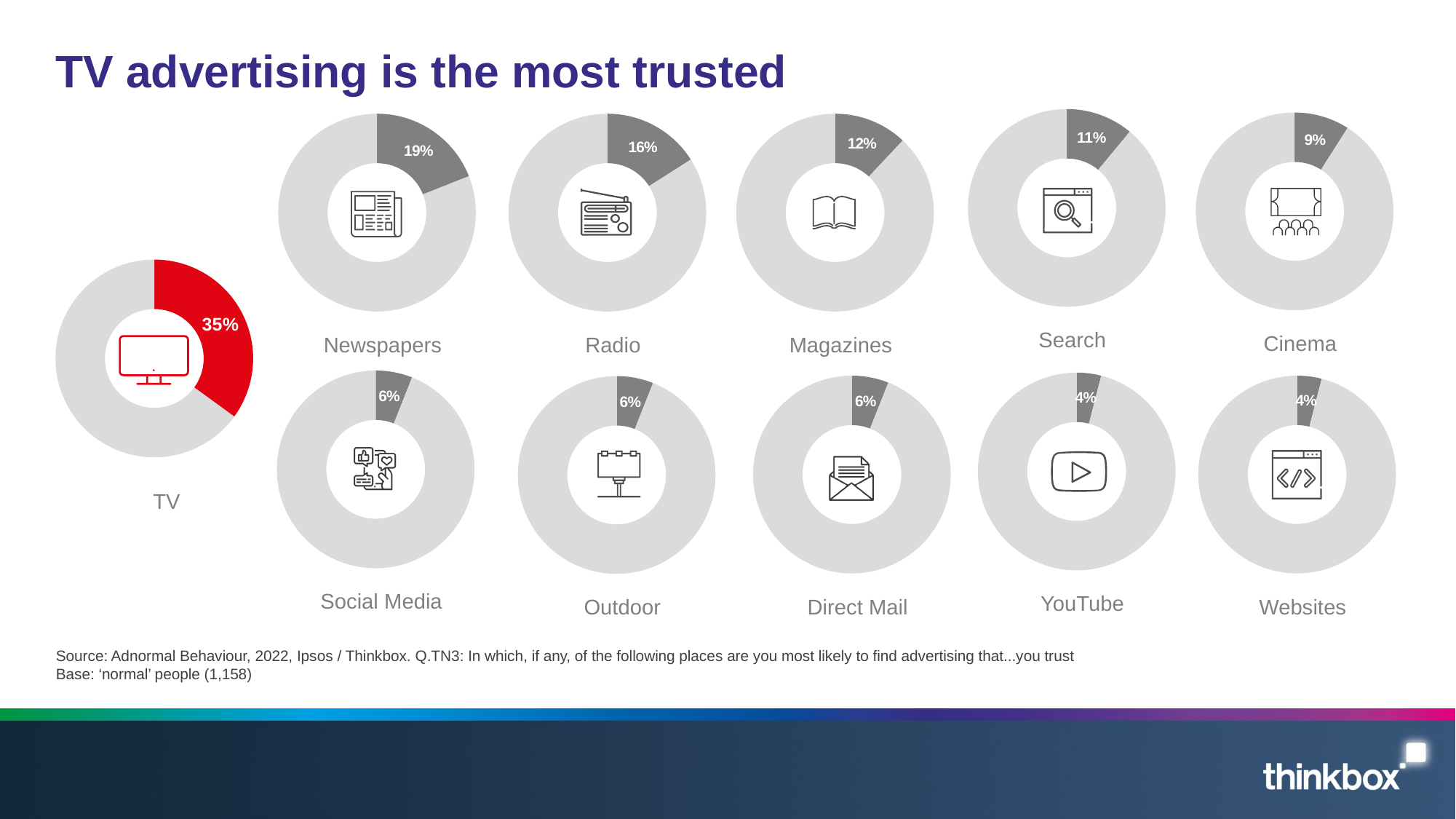
Across all the donut charts on the slide, which medium has the highest percentage? TV Comparing the Magazines and Search donut charts, which shows the larger percentage? Magazines Across all the donut charts on the slide, what is the difference between the TV percentage and the Newspapers percentage? 16% How many donut charts are shown on the slide? 11 What is the title of the slide containing the donut charts? TV advertising is the most trusted In the Newspapers donut chart, what percentage is shown? 19% What kind of chart is used for each medium on the slide? Donut chart In the YouTube donut chart, what percentage is shown? 4% Which donut chart on the slide uses a red segment instead of grey? TV In the TV donut chart, what percentage is shown? 35% In the Cinema donut chart, what percentage is shown? 9% In the Radio donut chart, what percentage is shown? 16%